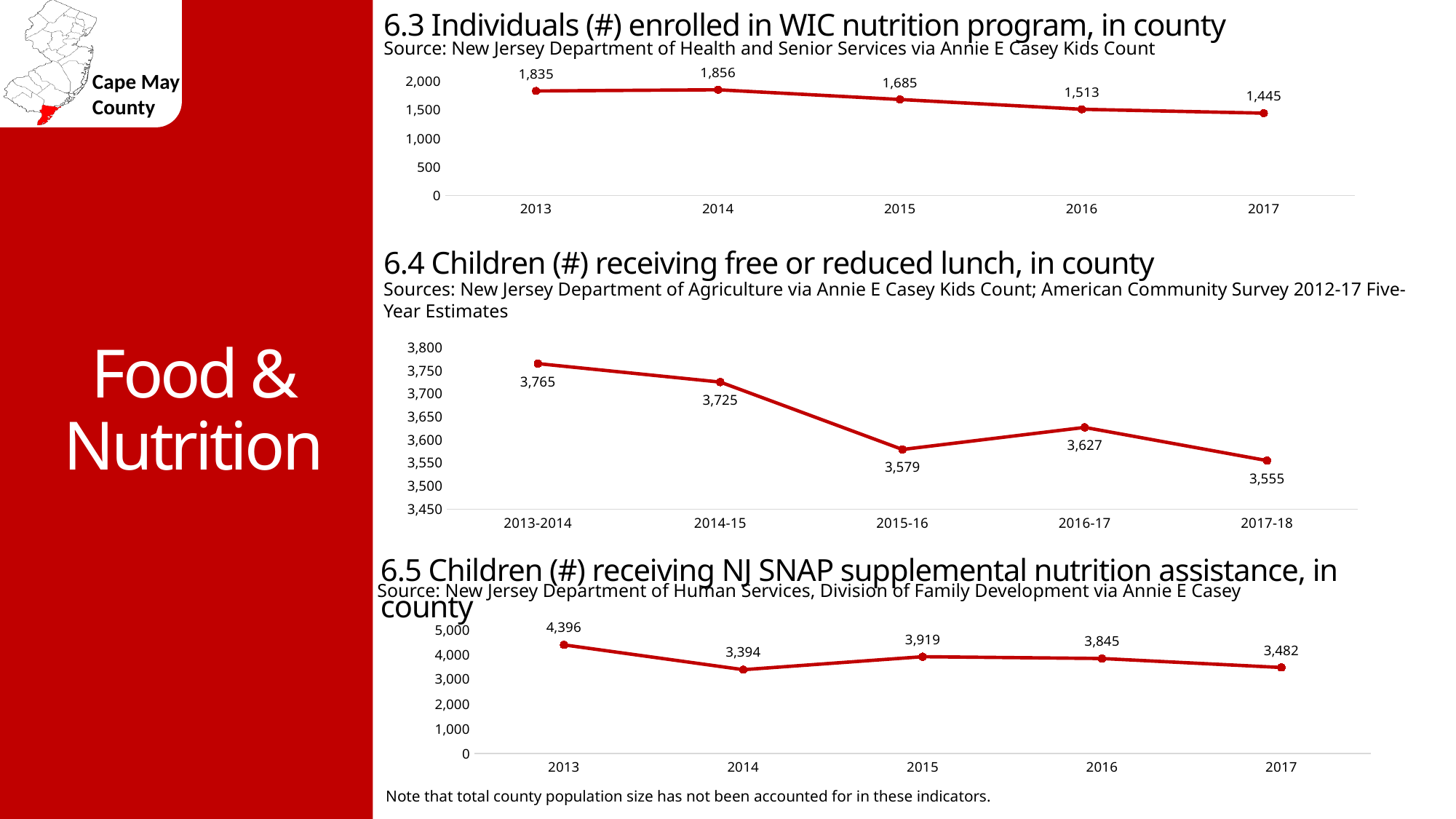
In the chart '6.5 Children (#) receiving NJ SNAP supplemental nutrition assistance, in county', is the value for 2017 greater or less than 4,000? less In the chart '6.4 Children (#) receiving free or reduced lunch, in county', which is larger, the value for 2015-16 or 2017-18? 2015-16 In the chart '6.4 Children (#) receiving free or reduced lunch, in county', what kind of chart is shown? Line chart In the chart '6.4 Children (#) receiving free or reduced lunch, in county', which school year has the highest value? 2013-2014 In the chart '6.5 Children (#) receiving NJ SNAP supplemental nutrition assistance, in county', which year has the lowest value? 2014 In the chart '6.5 Children (#) receiving NJ SNAP supplemental nutrition assistance, in county', what is the value for 2013? 4,396 In the chart '6.3 Individuals (#) enrolled in WIC nutrition program, in county', what is the value for 2014? 1,856 In the chart '6.4 Children (#) receiving free or reduced lunch, in county', what is the value for 2016-17? 3,627 In the chart '6.3 Individuals (#) enrolled in WIC nutrition program, in county', which year has the lowest value? 2017 In the chart '6.3 Individuals (#) enrolled in WIC nutrition program, in county', what is the difference between the 2013 and 2017 values? 390 In the chart '6.5 Children (#) receiving NJ SNAP supplemental nutrition assistance, in county', what is the difference between the 2015 and 2016 values? 74 In the chart '6.3 Individuals (#) enrolled in WIC nutrition program, in county', how many years are plotted? 5